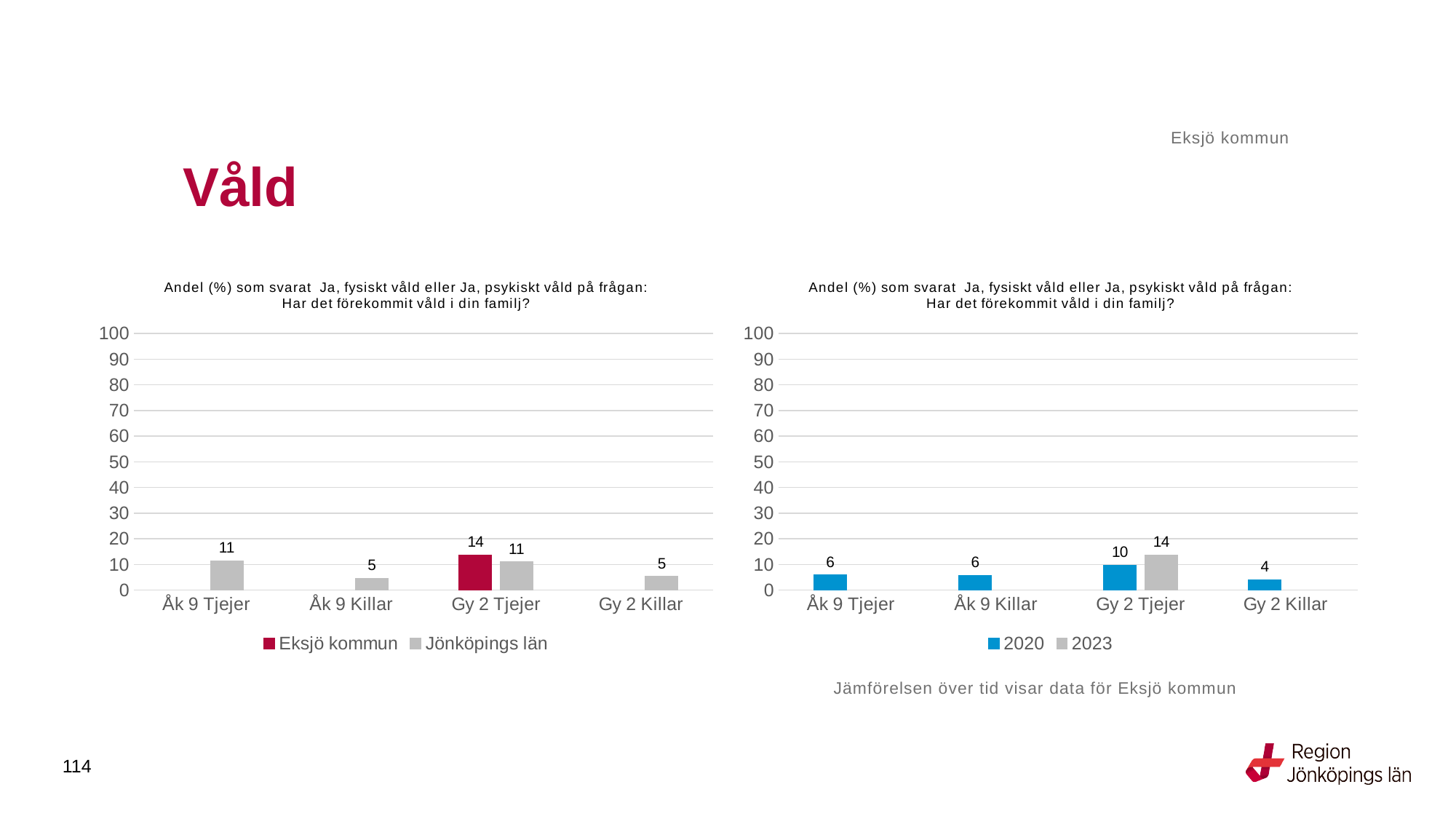
In the left chart, what is the value for Jönköpings län for Gy 2 Killar? 5 In the left chart, what is the value for Eksjö kommun for Gy 2 Tjejer? 14 In the right chart, what is the 2023 value for Gy 2 Tjejer? 14 In the left chart, what is the difference between Eksjö kommun and Jönköpings län for Gy 2 Tjejer? 3 In the right chart, what is the 2020 value for Gy 2 Tjejer? 10 In the right chart, what is the 2020 value for Gy 2 Killar? 4 In the left chart, what is the value for Jönköpings län for Åk 9 Tjejer? 11 In the left chart, which category has the lowest value for Jönköpings län? Åk 9 Killar and Gy 2 Killar (both 5) In the right chart, which category has the highest 2020 value? Gy 2 Tjejer In the right chart, is the 2020 value for Gy 2 Tjejer larger or smaller than the 2023 value for Gy 2 Tjejer? smaller In the left chart, how many series does the legend list? 2 What kind of chart is the right chart? bar chart